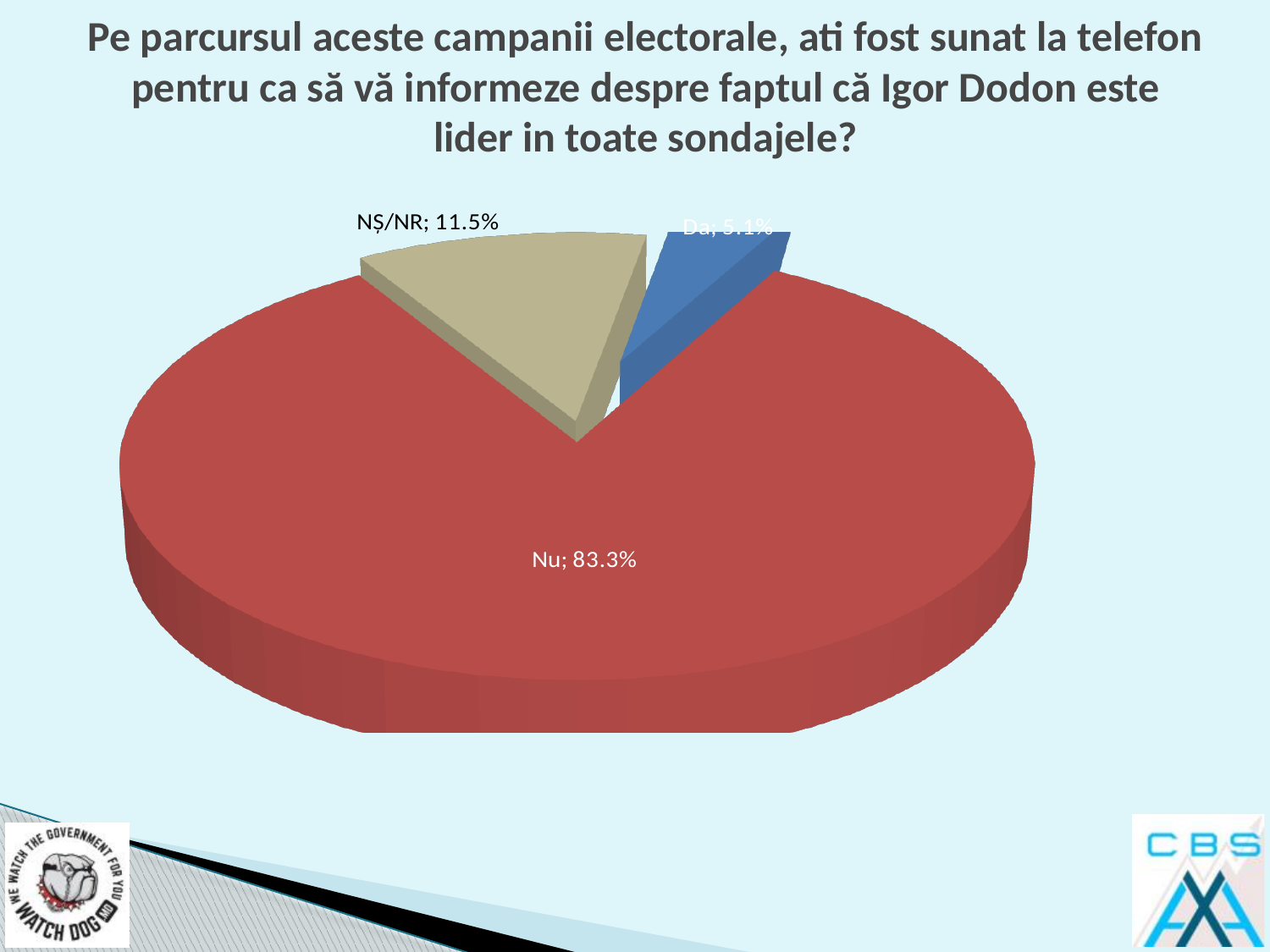
What is the value for Nu? 83.3% What is the difference between the values for Nu and NȘ/NR? 71.8% Which category has the largest share of the pie? Nu What colour is the slice for Nu? red How many slices does the pie chart have? 3 What is the value for Da? 5.1% What kind of chart is shown on the slide? pie chart Which is larger, the value for NȘ/NR or the value for Da? NȘ/NR What colour is the slice for Da? blue Which category has the smallest share of the pie? Da What is the difference between the values for NȘ/NR and Da? 6.4% What is the value for NȘ/NR? 11.5%